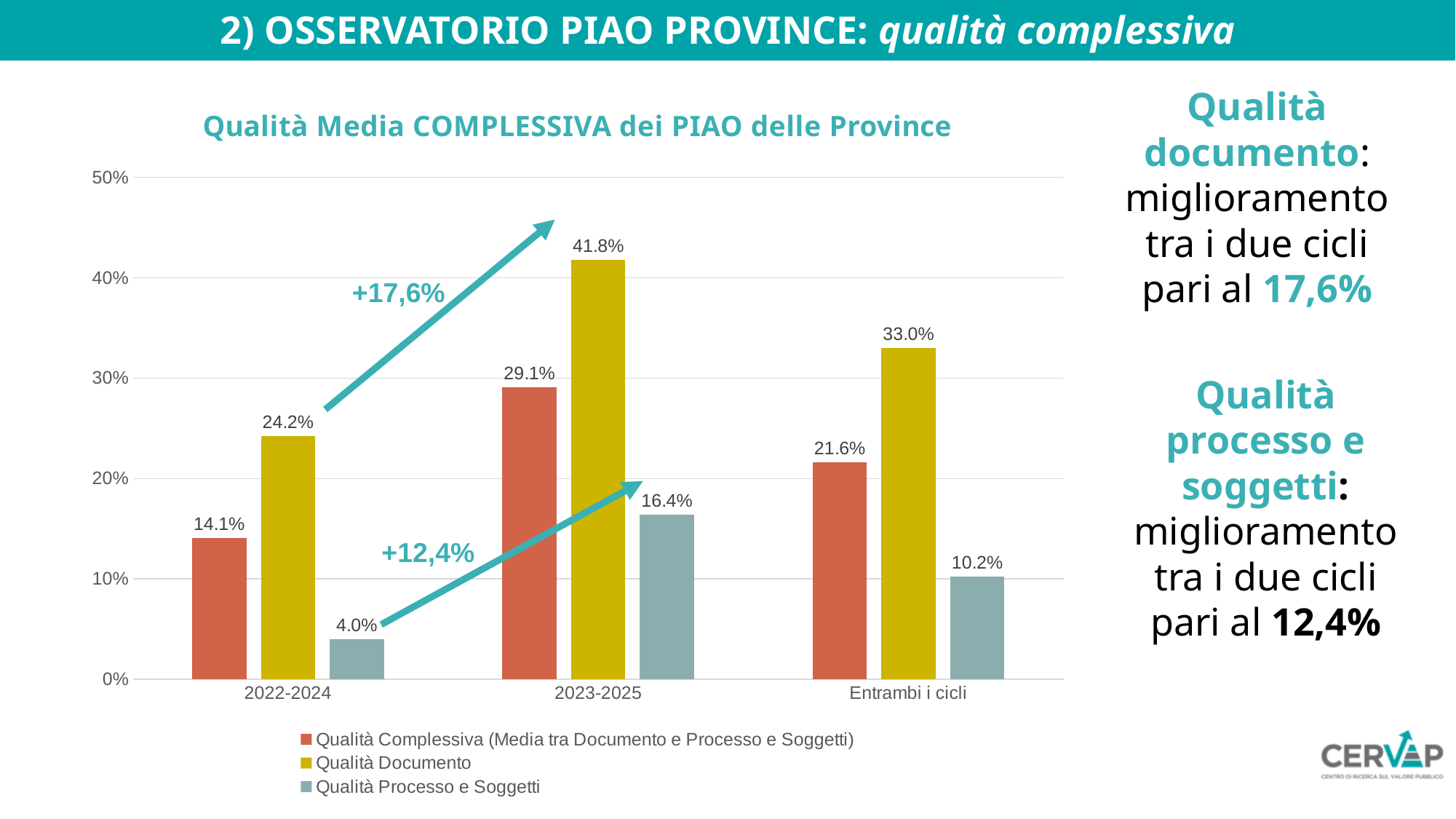
How many categories are shown on the x axis? 3 What is the value of Qualità Processo e Soggetti for 2022-2024? 4.0% What is the difference between Qualità Documento in 2023-2025 and in 2022-2024? 17.6% What kind of chart is shown on the slide? Bar chart Which category has the highest value for Qualità Documento? 2023-2025 Which is larger: Qualità Complessiva for 2023-2025 or Qualità Documento for Entrambi i cicli? Qualità Documento for Entrambi i cicli What is the value of Qualità Complessiva for Entrambi i cicli? 21.6% What is the title of the chart? Qualità Media COMPLESSIVA dei PIAO delle Province How many series does the legend list? 3 Is the value of Qualità Documento for 2023-2025 greater or less than 40%? greater Which category has the lowest value for Qualità Processo e Soggetti? 2022-2024 What is the value of Qualità Documento for 2023-2025? 41.8%